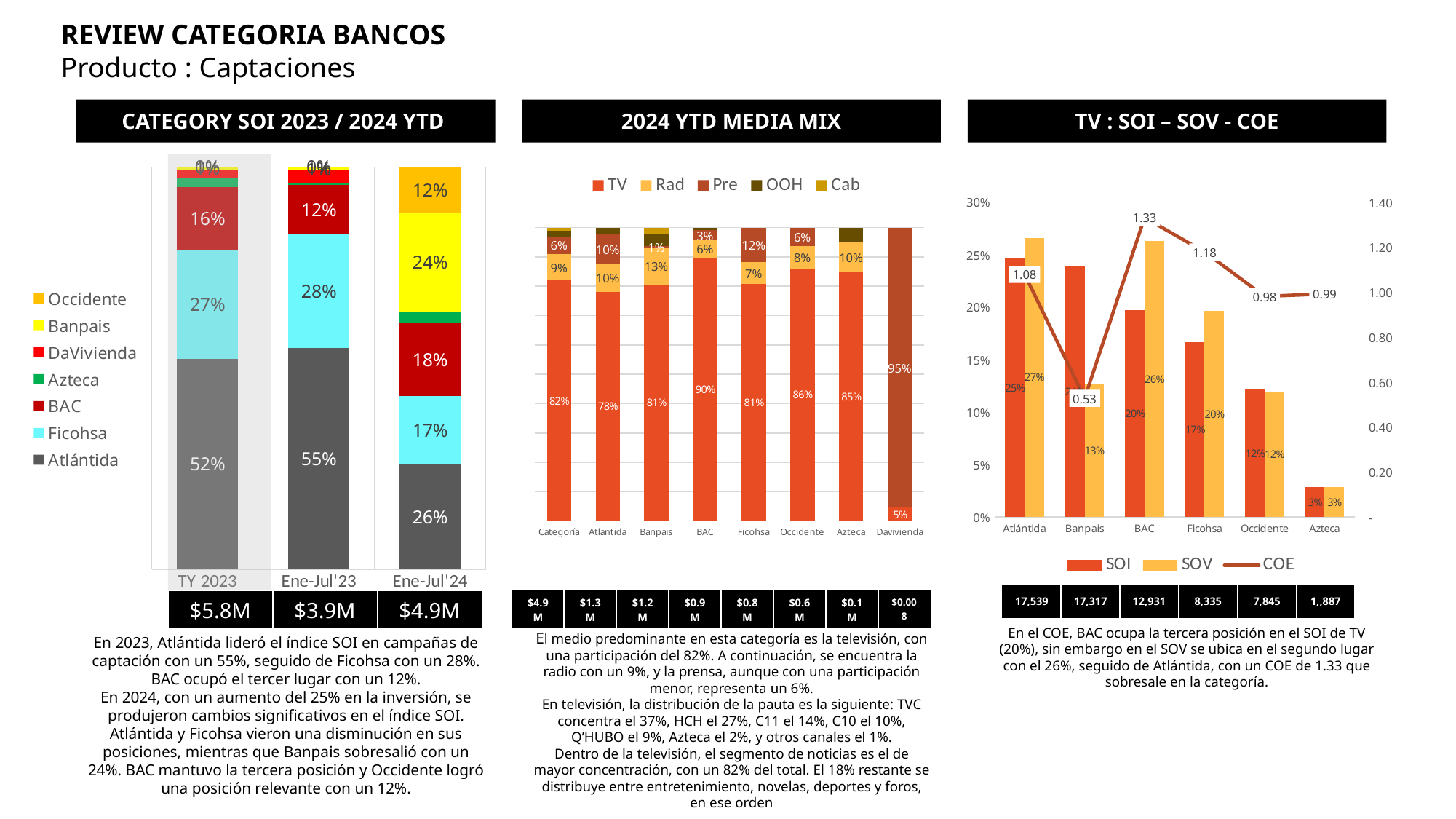
In the 2024 YTD MEDIA MIX chart, how many categories are shown on the x axis? 8 What kind of chart is the TV : SOI – SOV - COE chart? Combined bar and line chart In the CATEGORY SOI 2023 / 2024 YTD chart, what is the value for Atlántida in the Ene-Jul'24 bar? 26% In the CATEGORY SOI 2023 / 2024 YTD chart, how many series does the legend list? 7 In the 2024 YTD MEDIA MIX chart, what is the TV share for BAC? 90% In the CATEGORY SOI 2023 / 2024 YTD chart, what is the value for Banpais in the Ene-Jul'24 bar? 24% In the TV : SOI – SOV - COE chart, which bank has the lowest COE value? Banpais In the 2024 YTD MEDIA MIX chart, which category has the lowest TV share? Davivienda In the TV : SOI – SOV - COE chart, is the SOV for Atlántida or the SOV for BAC larger? Atlántida In the 2024 YTD MEDIA MIX chart, what is the Rad share for Banpais? 13% In the TV : SOI – SOV - COE chart, what is the COE value for BAC? 1.33 In the CATEGORY SOI 2023 / 2024 YTD chart, what is the difference between the Atlántida values for Ene-Jul'23 and Ene-Jul'24? 29 percentage points